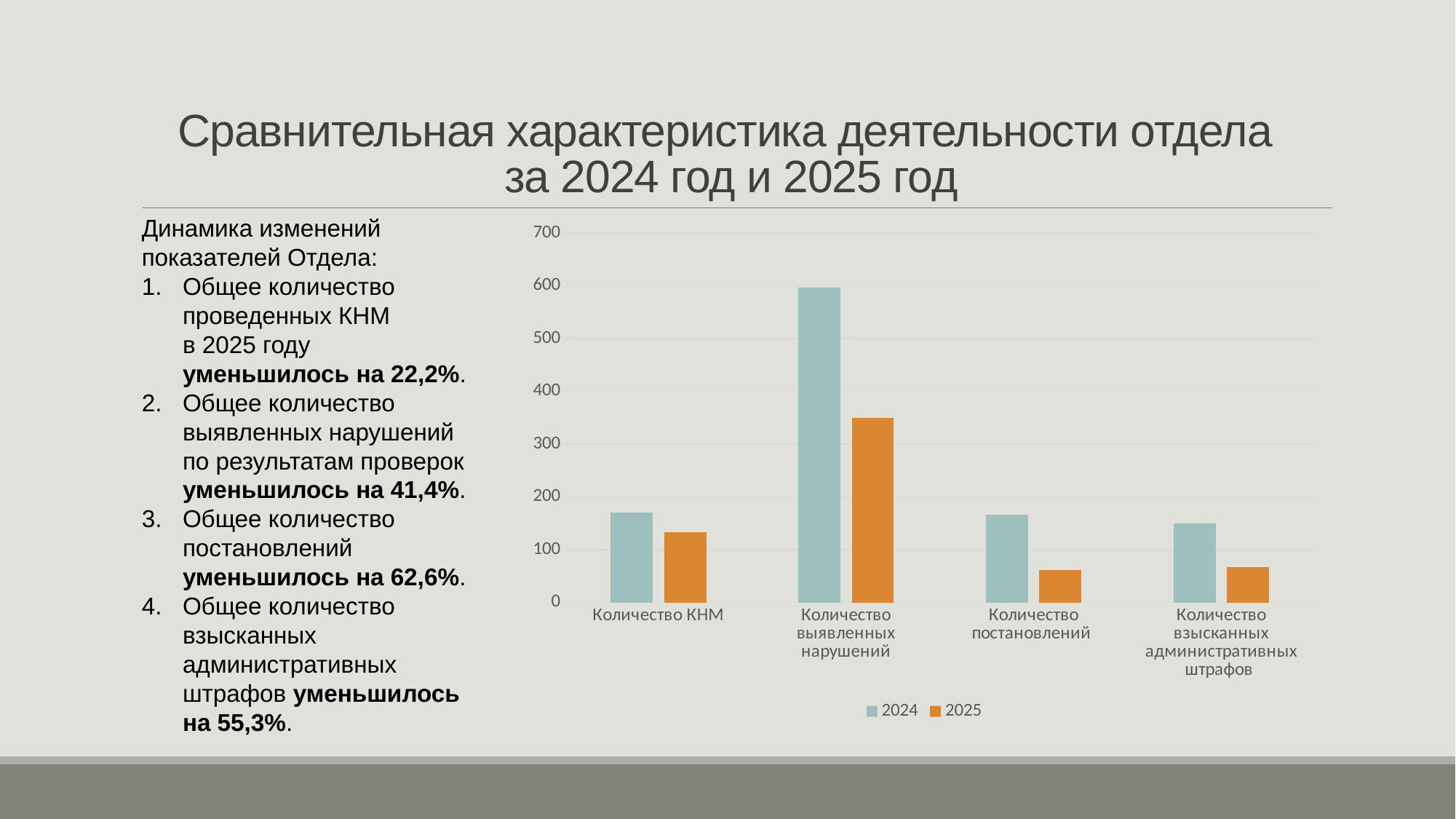
Is the 2024 value for Количество выявленных нарушений greater or less than 500? greater Is the 2025 value for Количество постановлений greater or less than 100? less Which series are listed in the chart legend? 2024 and 2025 Which category has the highest value for the 2025 series? Количество выявленных нарушений For Количество постановлений, which series has the larger value, 2024 or 2025? 2024 Is the 2024 value for Количество КНМ greater or less than 100? greater How many categories are shown on the x axis of the chart? 4 What kind of chart is shown on the slide? Bar chart Which category has the highest value for the 2024 series? Количество выявленных нарушений How many series does the chart legend list? 2 Across all categories, are the 2025 values higher or lower than the 2024 values? lower